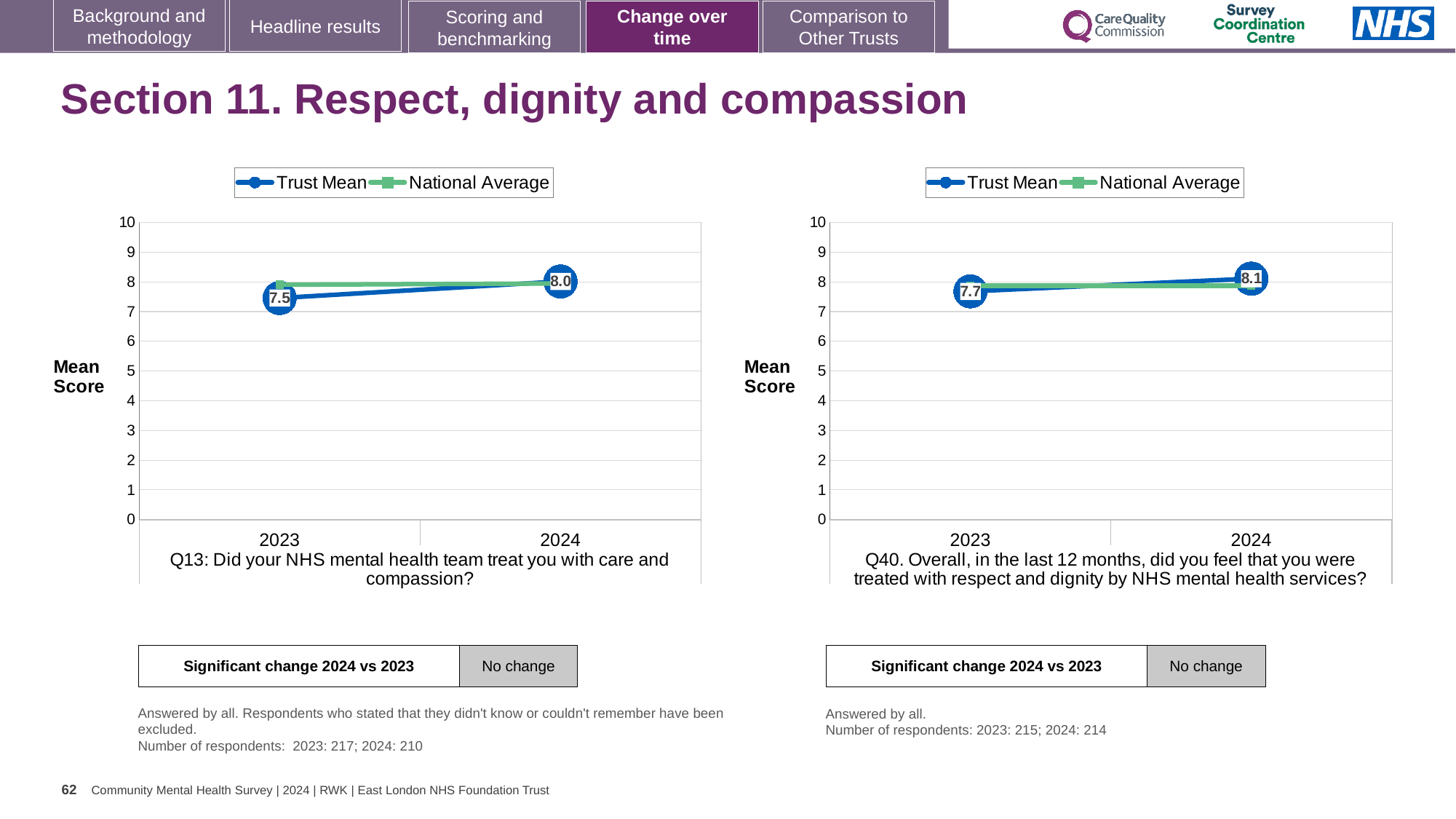
In the Q13 chart on the left, is the National Average for 2023 greater or less than 7? greater In the Q13 chart on the left, in 2023 which is higher, the Trust Mean or the National Average? National Average In the Q13 chart on the left, by how much did the Trust Mean change from 2023 to 2024? 0.5 In the Q40 chart on the right, what is the Trust Mean score for 2024? 8.1 In the Q13 chart on the left, does the Trust Mean rise or fall from 2023 to 2024? rise In the Q13 chart on the left, what is the Trust Mean score for 2023? 7.5 In the Q13 chart on the left, what is the Trust Mean score for 2024? 8.0 What type of chart is the Q13 chart on the left? line chart How many series does the legend of the Q40 chart on the right list? 2 In the Q40 chart on the right, which year has the higher Trust Mean, 2023 or 2024? 2024 In the Q40 chart on the right, what is the Trust Mean score for 2023? 7.7 In the Q40 chart on the right, what is the difference between the Trust Mean for 2024 and 2023? 0.4